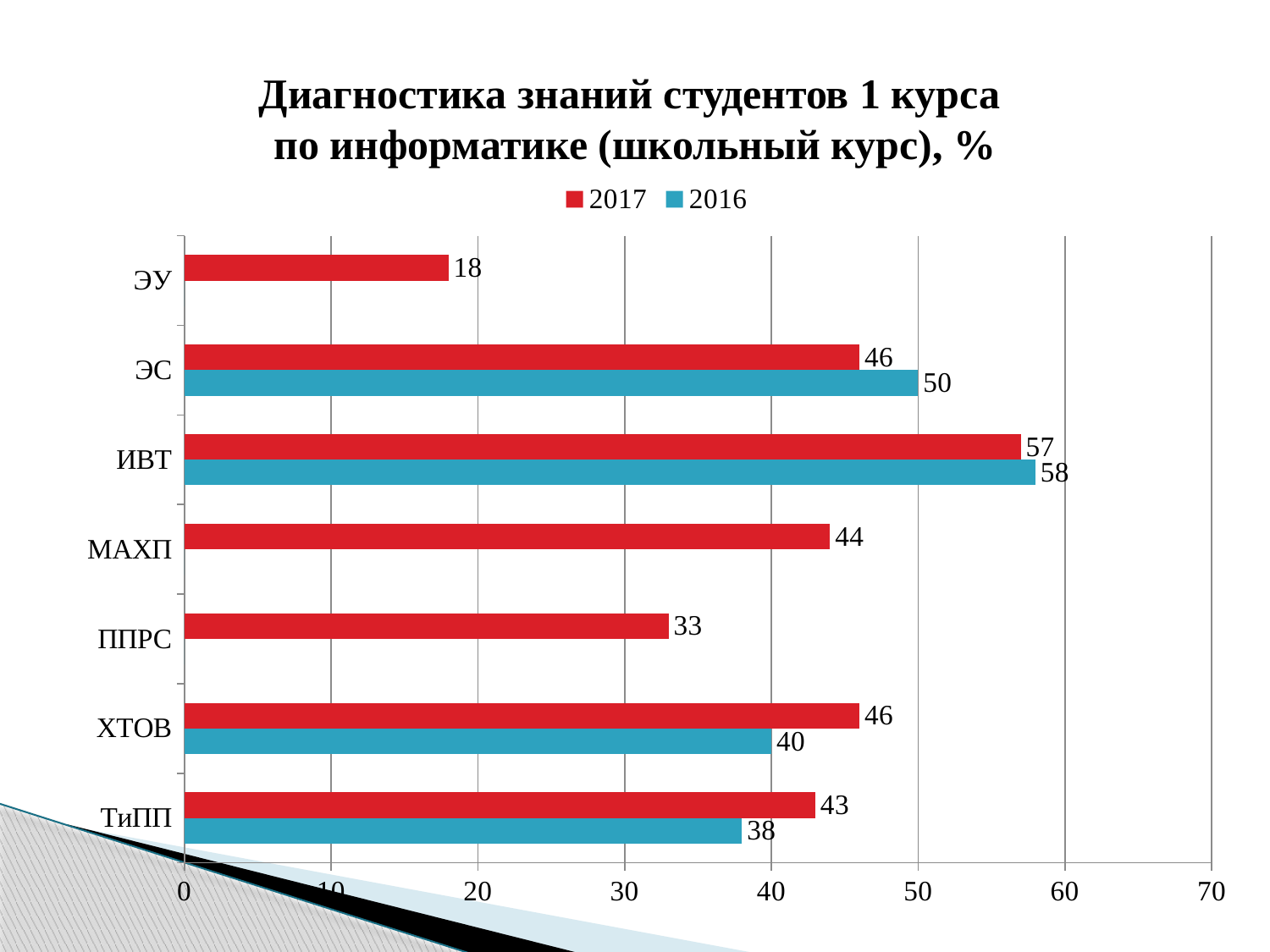
What is the 2017 value for ИВТ? 57 Which colour represents the 2016 series? blue What is the 2016 value for ЭС? 50 What is the difference between the 2017 and 2016 values for ХТОВ? 6 How many categories are shown on the chart? 7 Which category has the lowest 2017 value? ЭУ Which category has the highest 2017 value? ИВТ What kind of chart is shown on the slide? bar chart Which is larger for ТиПП, the 2017 value or the 2016 value? 2017 How many series does the legend list? 2 What is the 2017 value for ЭУ? 18 Is the 2017 value for ППРС greater or less than 40? less